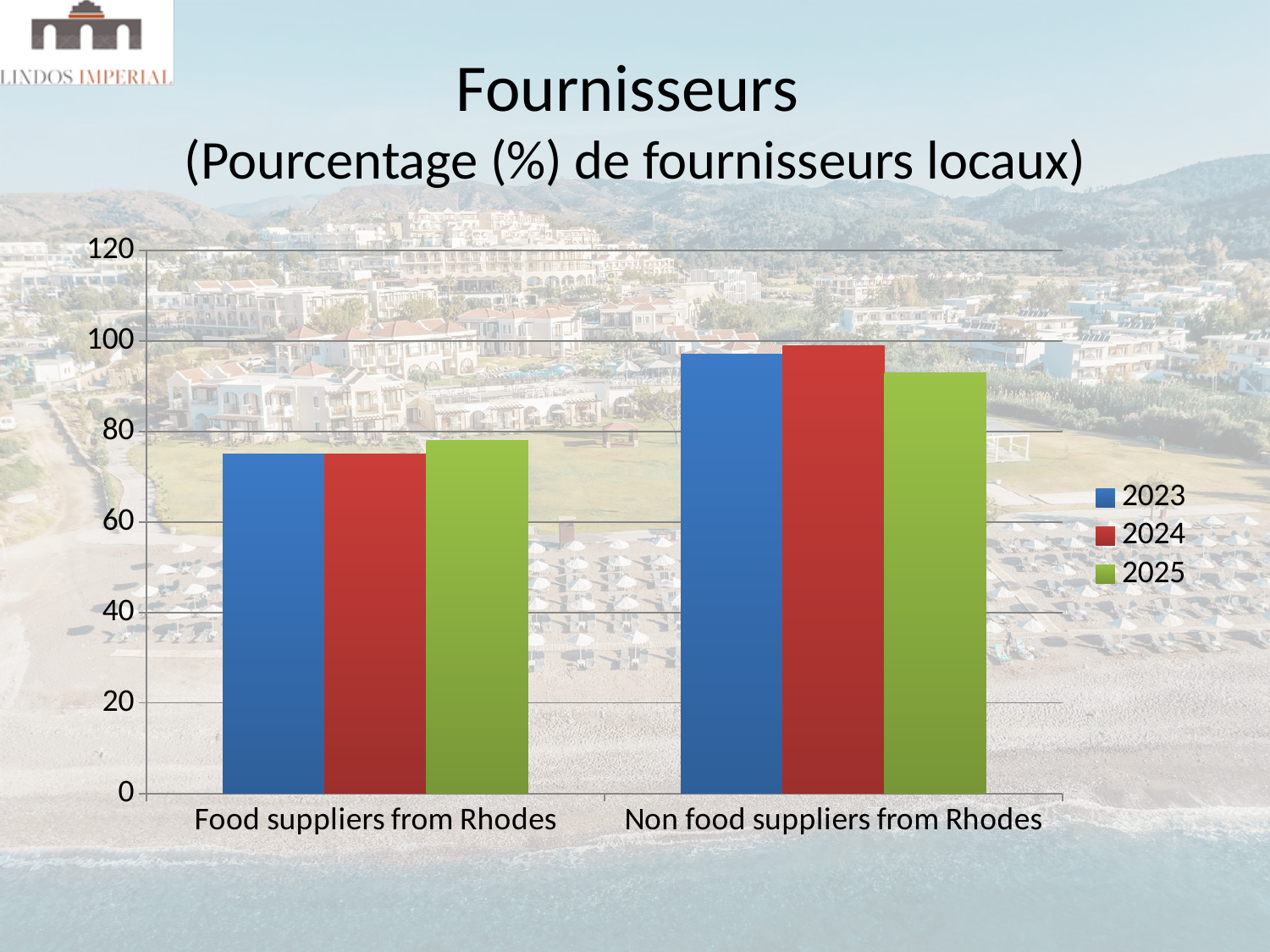
Which year has the lowest value for Non food suppliers from Rhodes? 2025 How many categories are shown on the x axis? 2 Which is larger for 2024, Food suppliers from Rhodes or Non food suppliers from Rhodes? Non food suppliers from Rhodes How many series does the legend list? 3 Is the 2023 value for Food suppliers from Rhodes greater or less than 60? greater Is the 2025 value for Non food suppliers from Rhodes greater or less than 80? greater Which colour represents 2025 in the legend? green Is the 2024 value for Non food suppliers from Rhodes greater or less than 80? greater Which category has the higher values overall, Food suppliers from Rhodes or Non food suppliers from Rhodes? Non food suppliers from Rhodes What kind of chart is shown on the slide? bar chart Which is larger for Non food suppliers from Rhodes, the 2024 value or the 2025 value? 2024